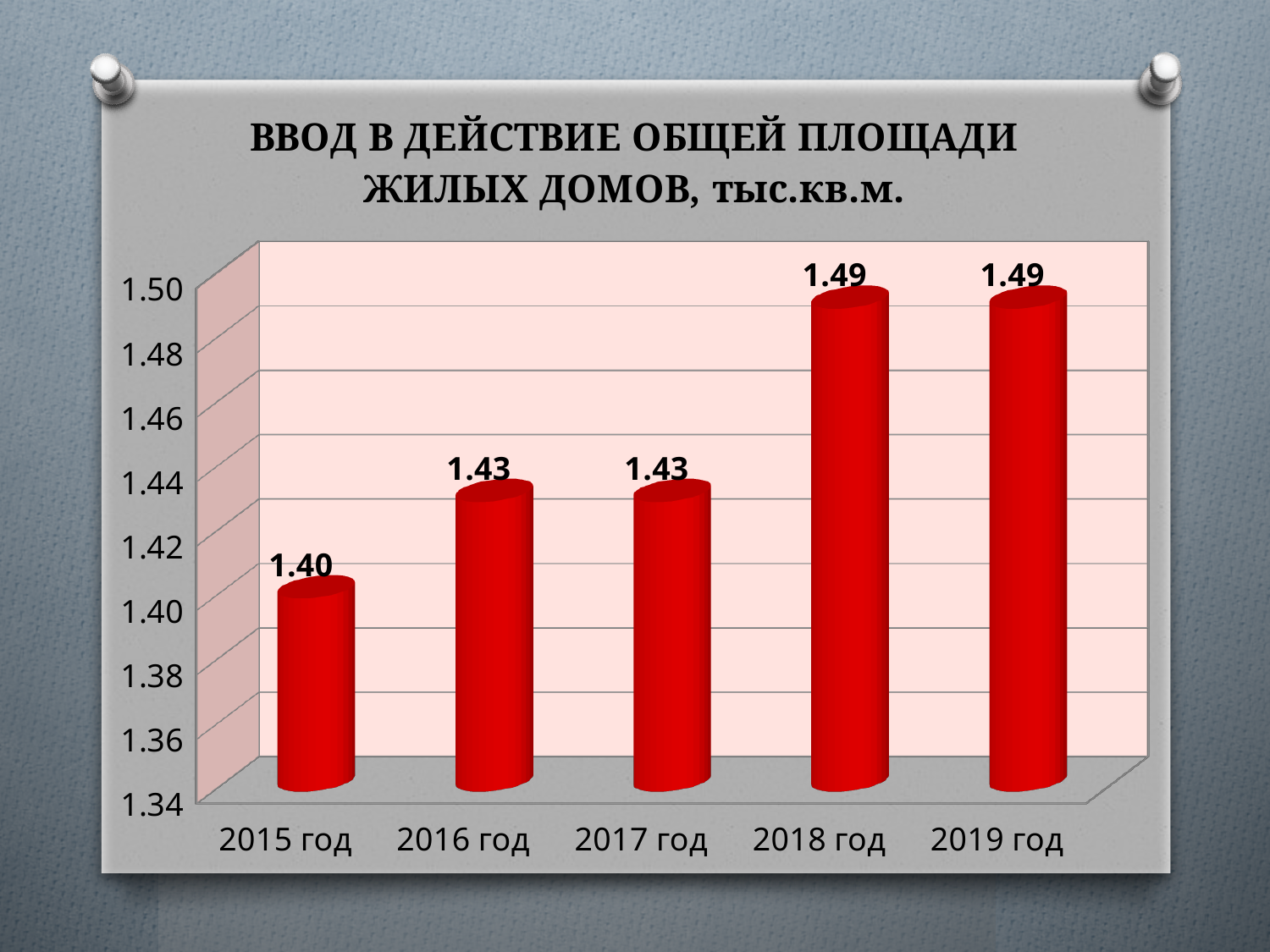
What is the difference between the values for 2016 год and 2015 год? 0.03 What is the value for 2015 год? 1.40 What is the value for 2016 год? 1.43 Is the value for 2017 год greater or less than 1.40? greater How many years are shown on the x axis? 5 What colour are the bars? red What is the difference between the values for 2018 год and 2015 год? 0.09 What is the value for 2018 год? 1.49 Which is larger, the value for 2017 год or the value for 2019 год? 2019 год Which year has the lowest value? 2015 год Do the values generally rise or fall from 2015 год to 2019 год? rise What kind of chart is this? bar chart